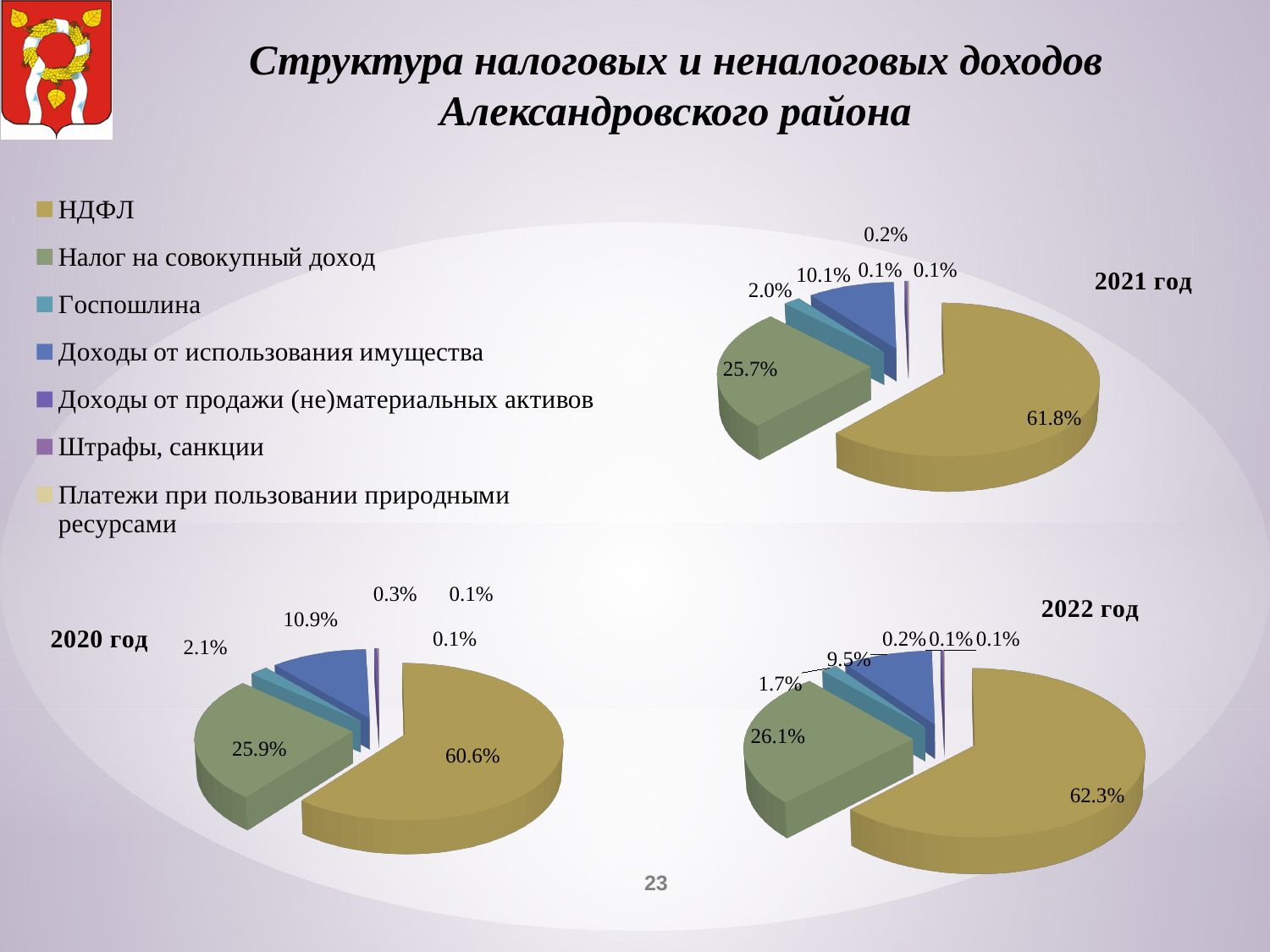
In the 2022 год pie chart, which is larger: the share of Госпошлина or the share of Доходы от использования имущества? Доходы от использования имущества What is the title of the slide containing the charts? Структура налоговых и неналоговых доходов Александровского района In the 2022 год pie chart, what share does Госпошлина have? 1.7% In the 2021 год pie chart, what share does НДФЛ have? 61.8% What type of chart is used for the 2020 год data? Pie chart How many pie charts are shown on the slide? 3 Which year's pie chart shows the highest share for НДФЛ? 2022 год In the 2021 год pie chart, which category has the largest share? НДФЛ In the 2020 год pie chart, what share does Налог на совокупный доход have? 25.9% How many categories does the legend list? 7 In the 2022 год pie chart, what share does Доходы от использования имущества have? 9.5% In the 2020 год pie chart, what is the difference between the shares of НДФЛ and Налог на совокупный доход? 34.7%